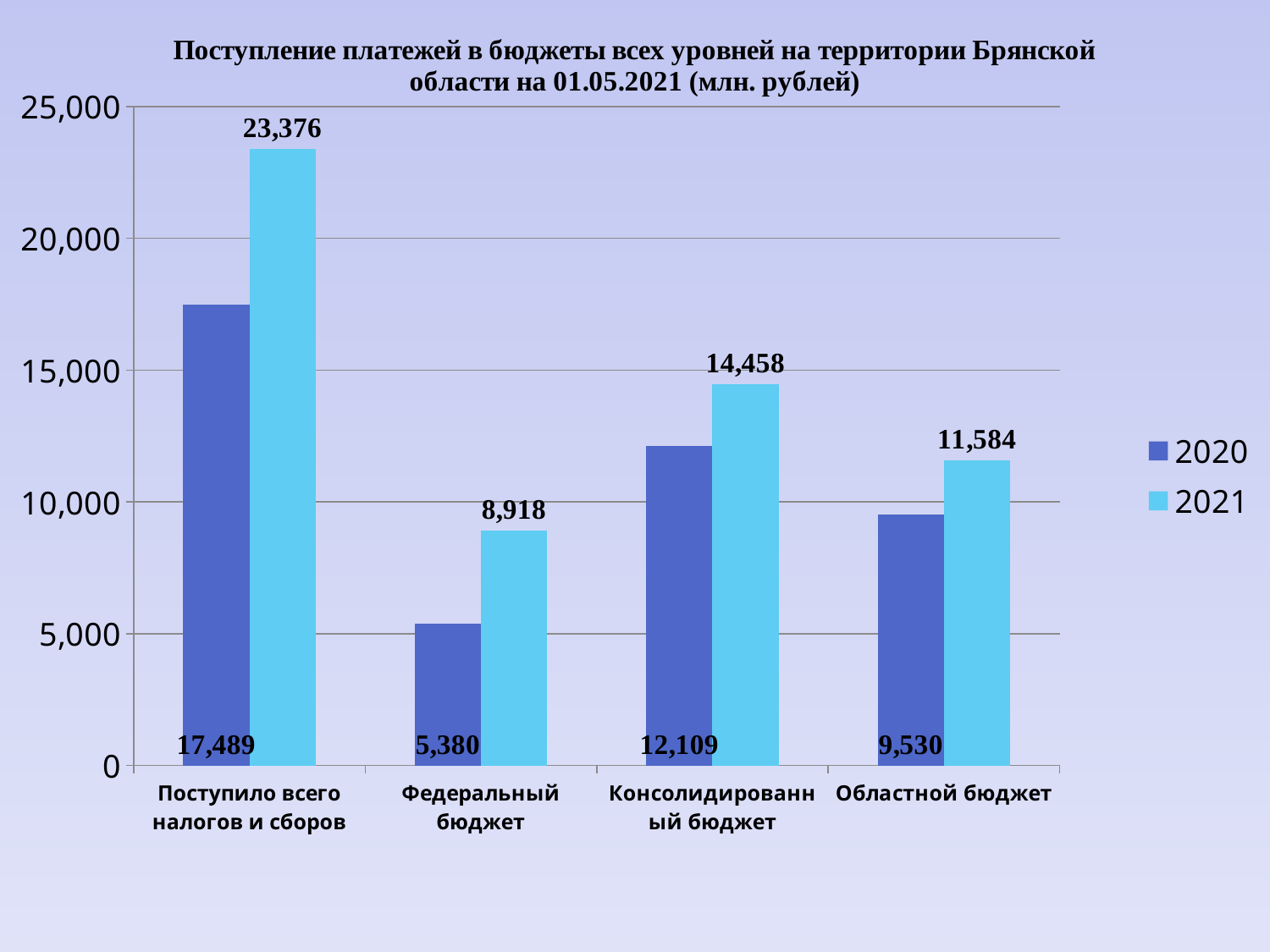
How many series does the legend list? 2 What is the difference between the 2021 and 2020 values for Поступило всего налогов и сборов? 5,887 What is the 2020 value for Федеральный бюджет? 5,380 Which category has the highest 2020 value? Поступило всего налогов и сборов How many categories are shown on the x axis? 4 What is the 2021 value for Консолидированный бюджет? 14,458 Which is larger: the 2020 value for Консолидированный бюджет or the 2021 value for Областной бюджет? 2020 value for Консолидированный бюджет What is the 2021 value for Поступило всего налогов и сборов? 23,376 What kind of chart is shown on the slide? Bar chart What is the 2020 value for Областной бюджет? 9,530 Which category has the lowest 2021 value? Федеральный бюджет What is the difference between the 2021 and 2020 values for Федеральный бюджет? 3,538